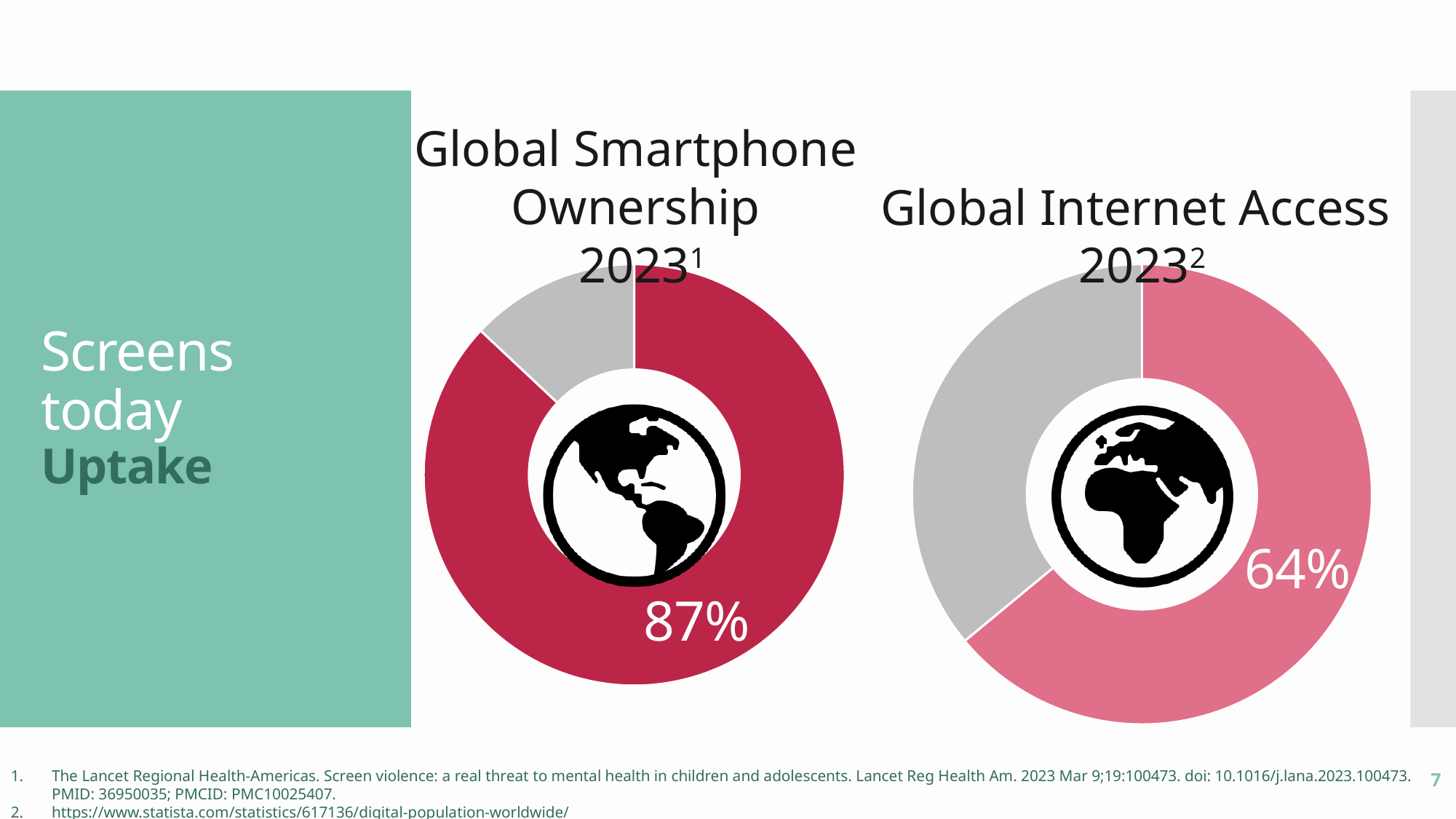
In the Global Internet Access 2023 chart, is the grey slice larger or smaller than the pink slice? smaller How many charts are shown on the slide? 2 What kind of chart is the Global Internet Access 2023 chart? Pie chart (donut) In the Global Internet Access 2023 chart, what percentage is shown on the pink slice? 64% What kind of chart is the Global Smartphone Ownership 2023 chart? Pie chart (donut) What is the title of the chart on the right side of the slide? Global Internet Access 2023 What is the difference between the labelled share in the Global Smartphone Ownership 2023 chart and the labelled share in the Global Internet Access 2023 chart? 23 percentage points How many slices does the Global Internet Access 2023 chart have? 2 Which chart shows the larger labelled share: Global Smartphone Ownership 2023 or Global Internet Access 2023? Global Smartphone Ownership 2023 How many slices does the Global Smartphone Ownership 2023 chart have? 2 In the Global Smartphone Ownership 2023 chart, is the labelled red slice greater or less than 50%? greater In the Global Smartphone Ownership 2023 chart, what percentage is shown on the red slice? 87%